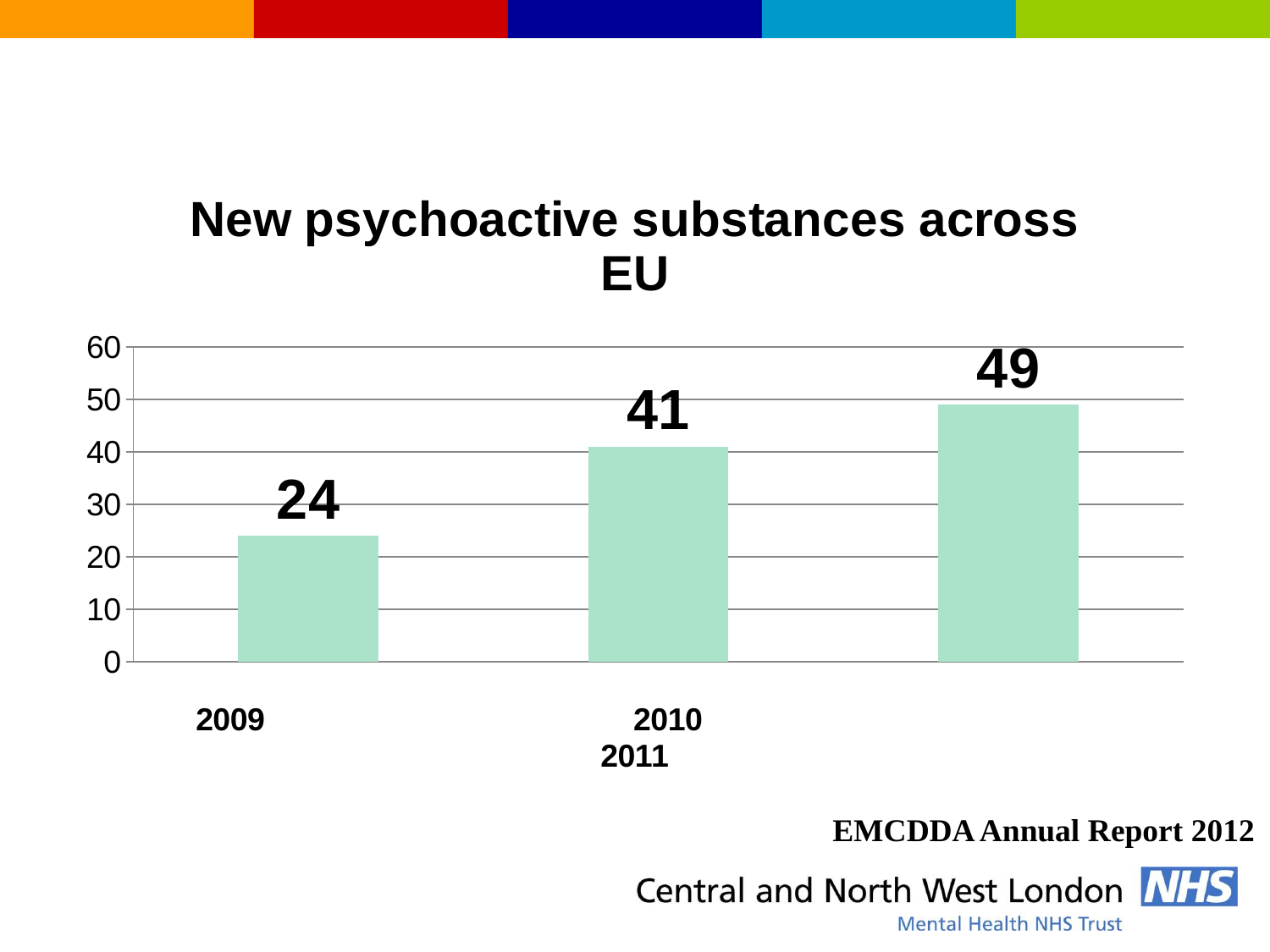
What is the value for 2009? 24 What is the difference between the values for 2010 and 2009? 17 Which year has the lowest value? 2009 Is the value for 2010 greater or less than 30? greater What kind of chart is shown on the slide? bar chart What is the difference between the values for 2011 and 2009? 25 Which year has the highest value? 2011 What is the value for 2010? 41 How many years are shown in the chart? 3 Do the values rise or fall from 2009 to 2011? rise What is the value for 2011? 49 Which is larger, the value for 2010 or the value for 2011? 2011